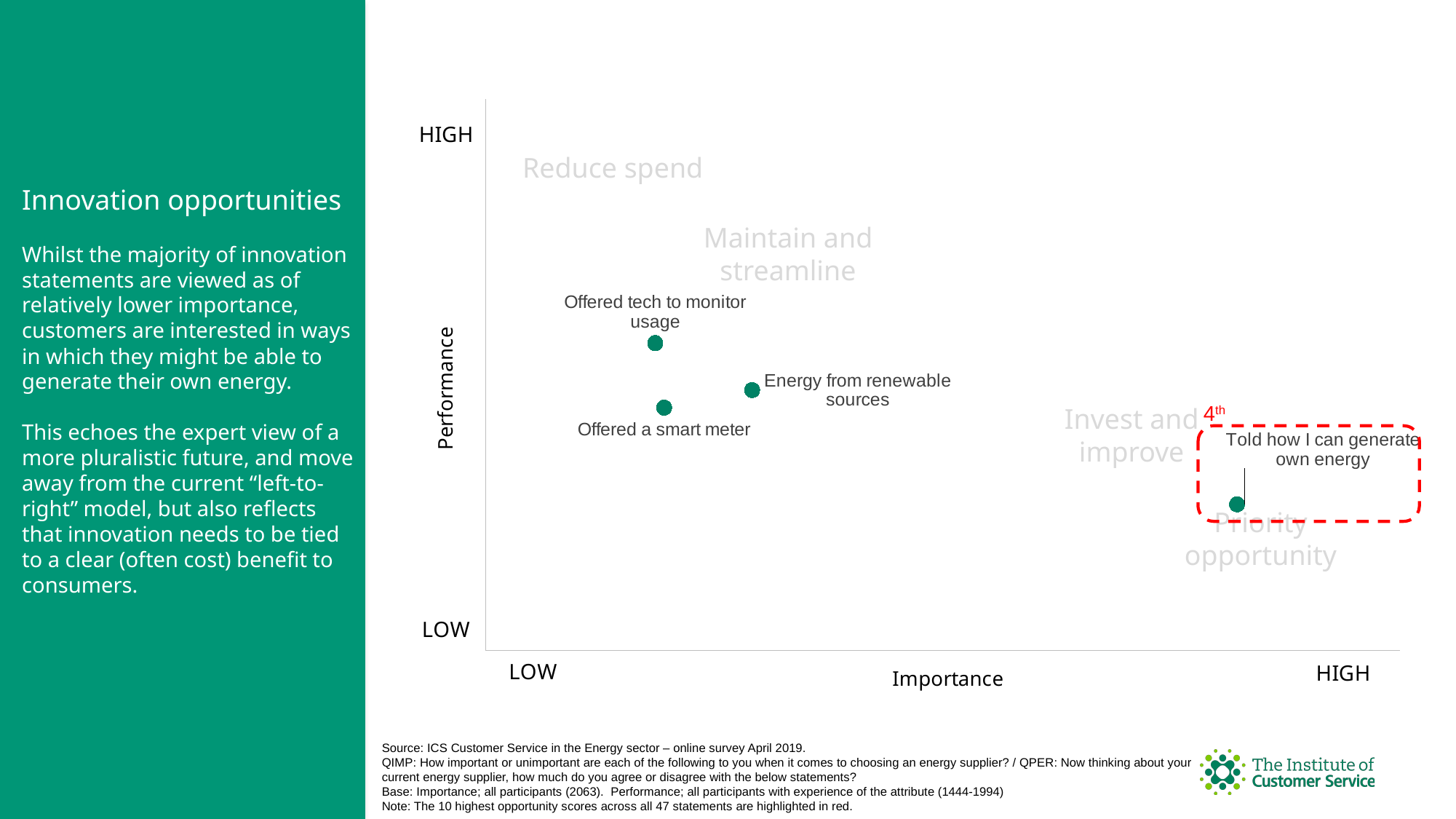
Which quadrant of the chart does 'Told how I can generate own energy' fall in? Priority opportunity What is the label of the vertical axis of the chart? Performance What rank is shown next to the point highlighted with the red dashed box? 4th Which plotted statement has the lowest performance? Told how I can generate own energy Which plotted statement has the highest performance? Offered tech to monitor usage Which plotted statement has the highest importance? Told how I can generate own energy How many data points are plotted on the chart? 4 What is the label of the horizontal axis of the chart? Importance Which has higher performance: 'Offered tech to monitor usage' or 'Energy from renewable sources'? Offered tech to monitor usage What kind of chart is shown on the slide? Scatter chart Which has higher importance: 'Told how I can generate own energy' or 'Energy from renewable sources'? Told how I can generate own energy Which has higher importance: 'Energy from renewable sources' or 'Offered a smart meter'? Energy from renewable sources